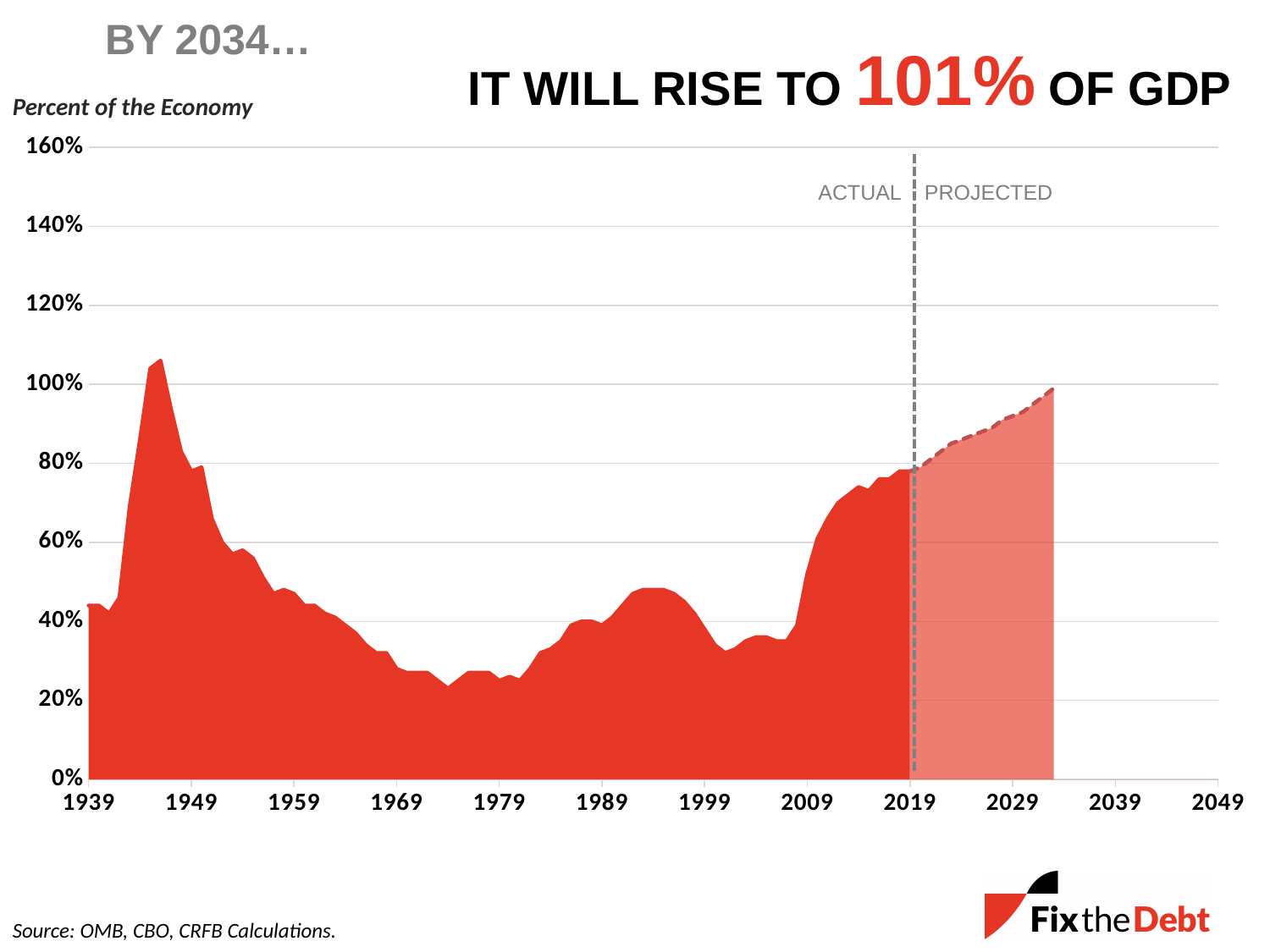
Do the values rise or fall across the projected portion of the chart? rise According to the slide title, what percent of GDP will the value rise to by 2034? 101% Is the value for 2009 greater or less than 40%? greater What kind of chart is shown on the slide? area chart Do the values rise or fall between 1949 and 1969? fall Which is larger, the value for 1939 or the value for 1969? 1939 How many year labels are shown on the x axis? 12 Is the value for 1979 greater or less than 40%? less Which is larger, the value for 1949 or the value for 1959? 1949 What year does the dashed line separating actual from projected values fall on? 2019 Is the value for 1969 greater or less than 40%? less